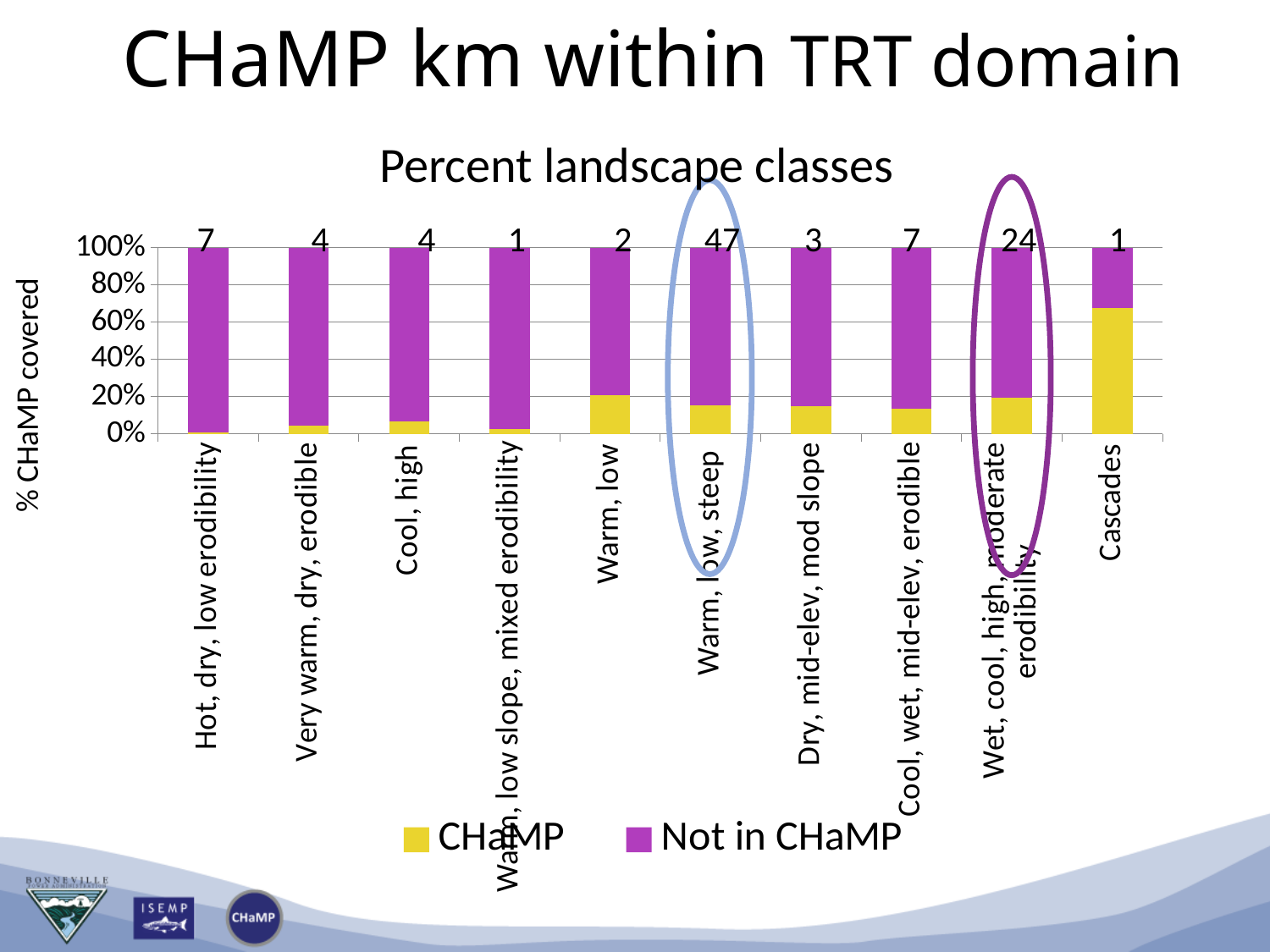
What number is printed above the bar for Wet, cool, high, moderate erodibility? 24 Which has a larger CHaMP share: Warm, low or Cool, high? Warm, low Which category has the largest CHaMP (yellow) share of its bar? Cascades How many landscape class categories are shown on the x axis of the chart? 10 Is the CHaMP share for Cascades greater or less than 40%? greater What is the title of the chart? Percent landscape classes What kind of chart is shown on the slide? Stacked bar chart Is the CHaMP share for Cool, high greater or less than 20%? less What number is printed above the bar for Warm, low, steep? 47 Which series is shown in purple in the chart legend? Not in CHaMP What number is printed above the bar for Hot, dry, low erodibility? 7 How many series does the chart legend list? 2